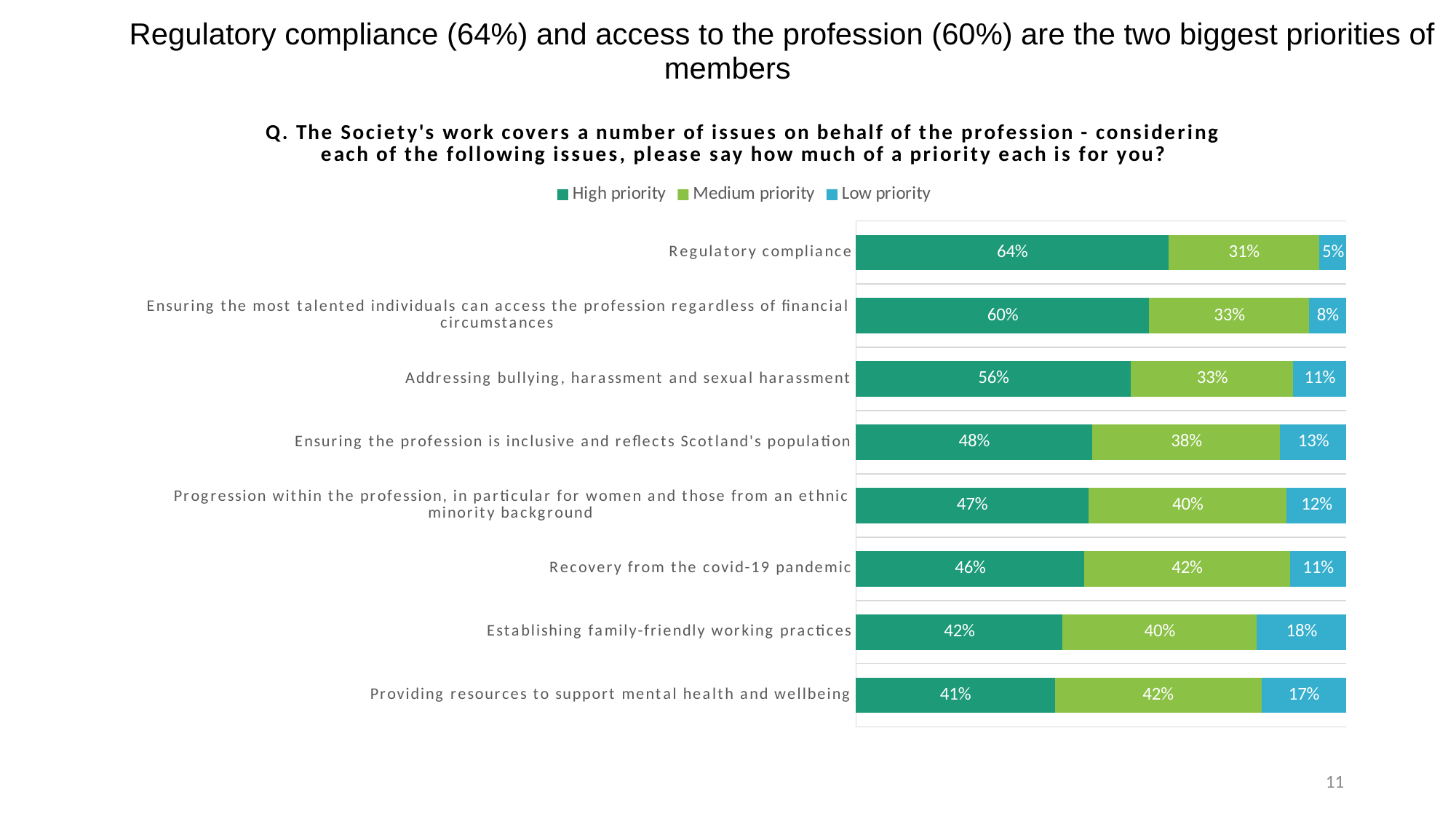
How many series does the legend list? 3 What is the Low priority value for Establishing family-friendly working practices? 18% Which issue has the highest High priority percentage? Regulatory compliance What percentage of members rate Regulatory compliance as a High priority? 64% What is the total of the three segments for the Regulatory compliance bar? 100% Which legend entry is shown in light blue? Low priority Which issue has the lowest High priority percentage? Providing resources to support mental health and wellbeing What kind of chart is shown on the slide? Stacked bar chart What is the difference between the High priority values for Regulatory compliance and Addressing bullying, harassment and sexual harassment? 8% How many issues are shown in the chart? 8 What is the Medium priority value for Recovery from the covid-19 pandemic? 42% Which has a larger Low priority value: Establishing family-friendly working practices or Providing resources to support mental health and wellbeing? Establishing family-friendly working practices